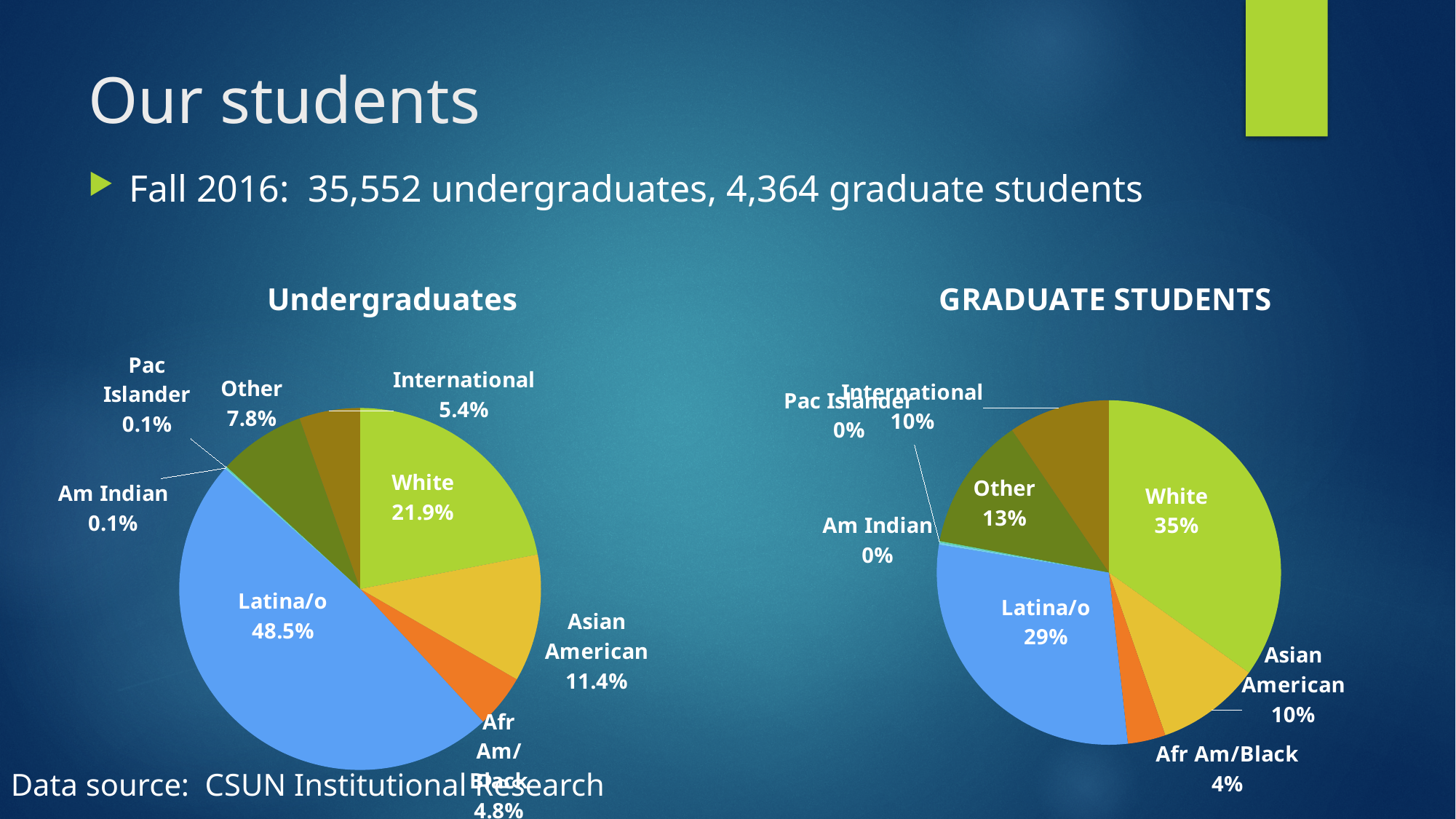
In the Undergraduates chart, what percentage is Asian American? 11.4% In the Undergraduates chart, what is the difference between the White and International shares? 16.5% How many categories are shown in the Undergraduates chart? 8 What type of chart is the GRADUATE STUDENTS chart? Pie chart In the GRADUATE STUDENTS chart, what percentage is White? 35% In the GRADUATE STUDENTS chart, what is the difference between the Latina/o and Afr Am/Black shares? 25% What is the title of the chart on the left side of the slide? Undergraduates In the GRADUATE STUDENTS chart, what percentage is Other? 13% In the Undergraduates chart, which category has the largest share? Latina/o In the GRADUATE STUDENTS chart, which category has the largest share? White In the Undergraduates chart, what percentage is Latina/o? 48.5% In the GRADUATE STUDENTS chart, which is larger, Other or International? Other